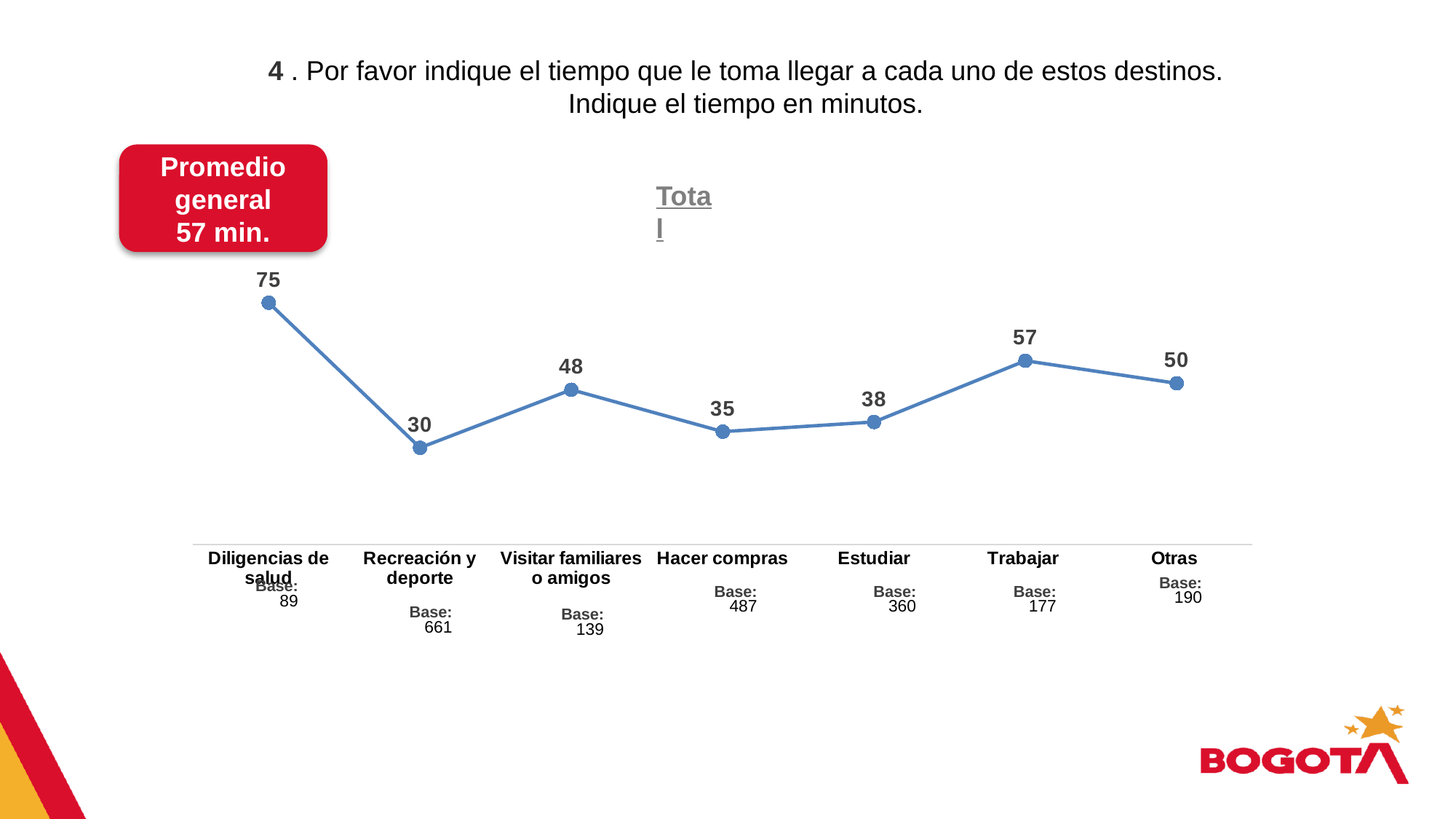
Which category has the highest value? Diligencias de salud What is the difference between the values for Trabajar and Estudiar? 19 What is the difference between the values for Diligencias de salud and Recreación y deporte? 45 What is the title of the chart? Total What is the value for Trabajar? 57 Which category has the lowest value? Recreación y deporte Which is larger, the value for Visitar familiares o amigos or the value for Otras? Otras What is the overall average (Promedio general) shown on the slide? 57 min. What kind of chart is shown on the slide? Line chart What is the value for Diligencias de salud? 75 How many categories are plotted on the chart? 7 What is the value for Hacer compras? 35